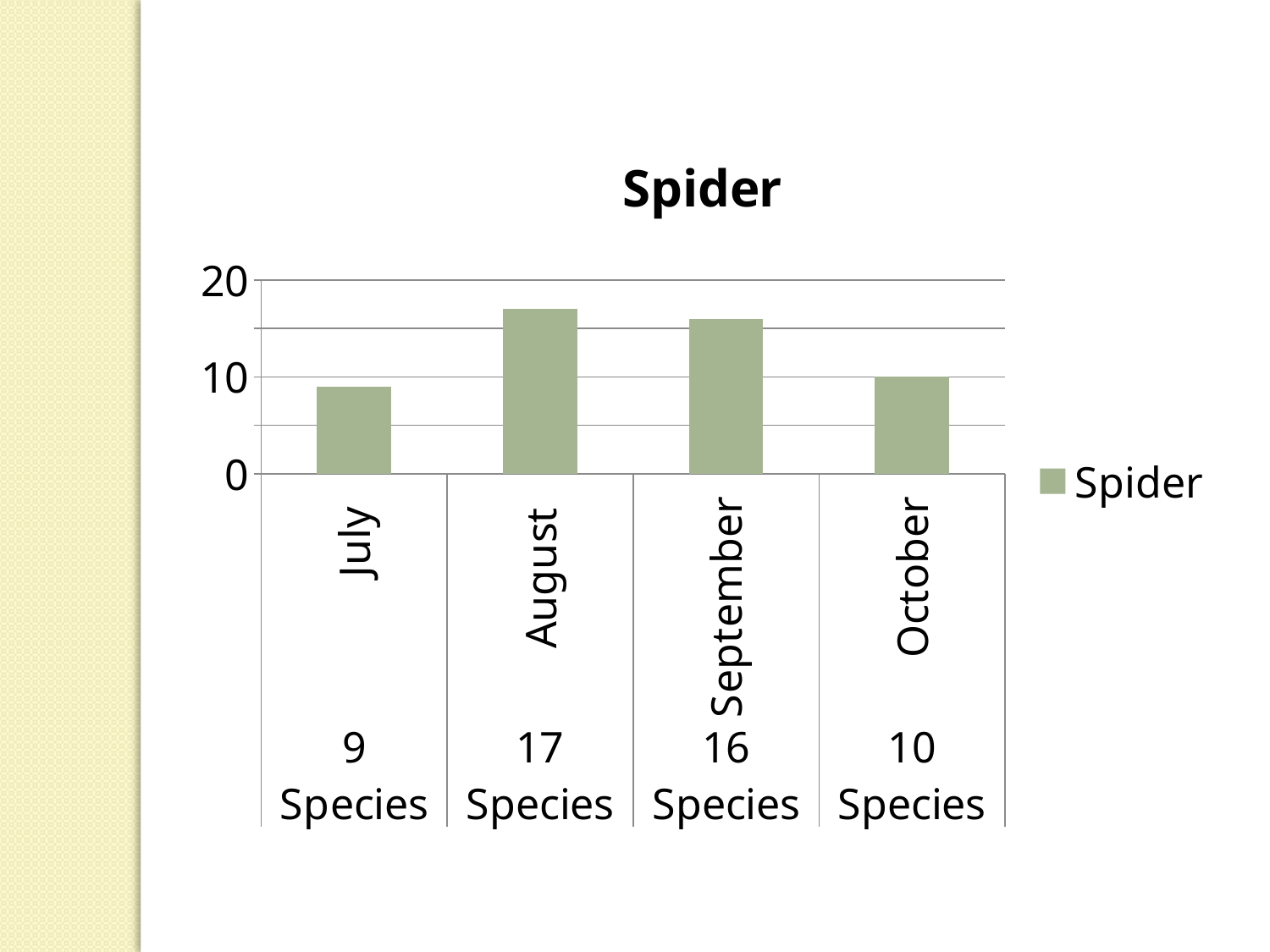
What is the value for July? 9 Species Which month has the highest number of species? August Which is larger, the value for September or the value for October? September Is the value for August greater or less than 10? greater Which month has the lowest number of species? July How many months are shown on the x axis? 4 What is the title of the chart? Spider What is the value for October? 10 Species What is the value for September? 16 Species How many series does the legend list? 1 What is the difference between the values for August and July? 8 What kind of chart is shown? bar chart